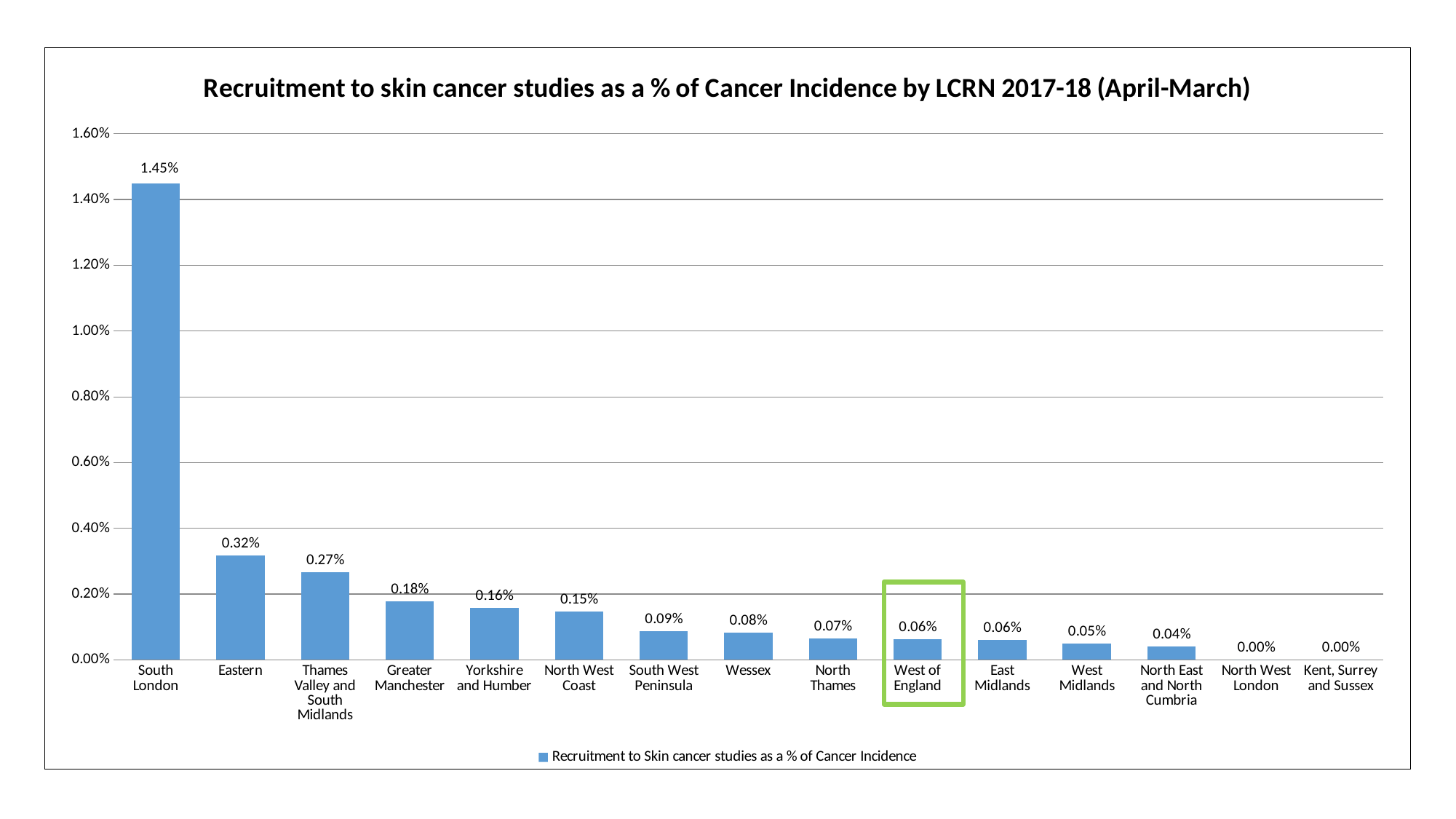
What is the value for West of England, the category highlighted with a green box? 0.06% Do the values rise or fall moving from left to right along the x axis? Fall Is the value for Eastern greater or less than 0.40%? less How many LCRNs show a value of 0.00%? 2 What is the value for Thames Valley and South Midlands? 0.27% What is the difference between the values for Thames Valley and South Midlands and Greater Manchester? 0.09% Which LCRN has the highest recruitment as a % of cancer incidence? South London What is the value for South London? 1.45% What is the difference between the values for South London and Eastern? 1.13% What kind of chart is shown on the slide? Bar chart Which is larger, the value for Yorkshire and Humber or the value for South West Peninsula? Yorkshire and Humber How many LCRNs are shown on the x axis? 15